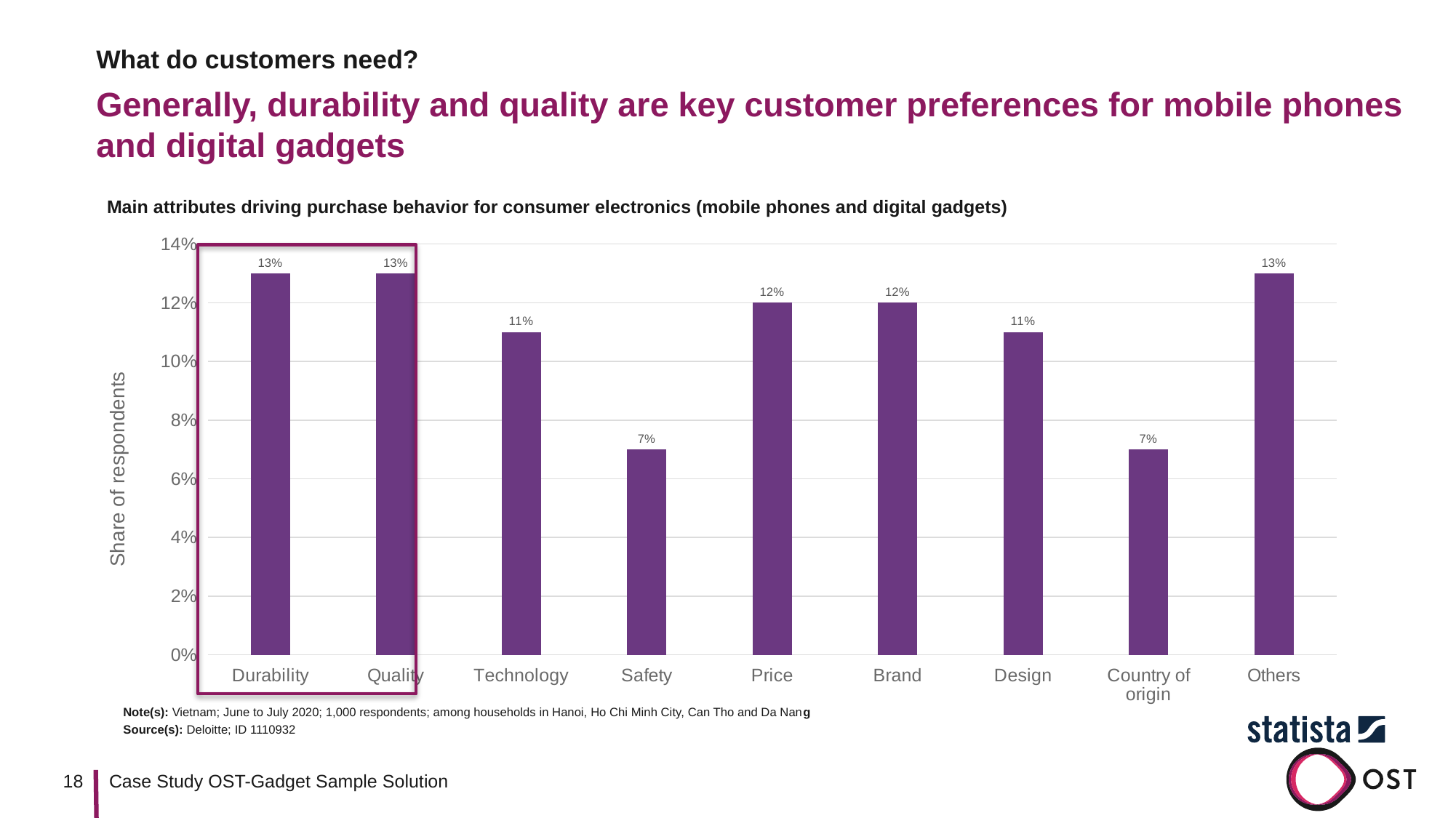
What is the value for Safety? 7% What is the value for Design? 11% What kind of chart is shown on the slide? Bar chart What is the value for Price? 12% How many categories are shown on the x axis? 9 What is the value for Country of origin? 7% What is the difference between the values for Quality and Technology? 2% What share of respondents chose Durability as a main attribute? 13% Which is larger, the value for Price or the value for Design? Price What is the label of the y axis? Share of respondents Which is larger, the value for Technology or the value for Country of origin? Technology What is the difference between the values for Brand and Safety? 5%